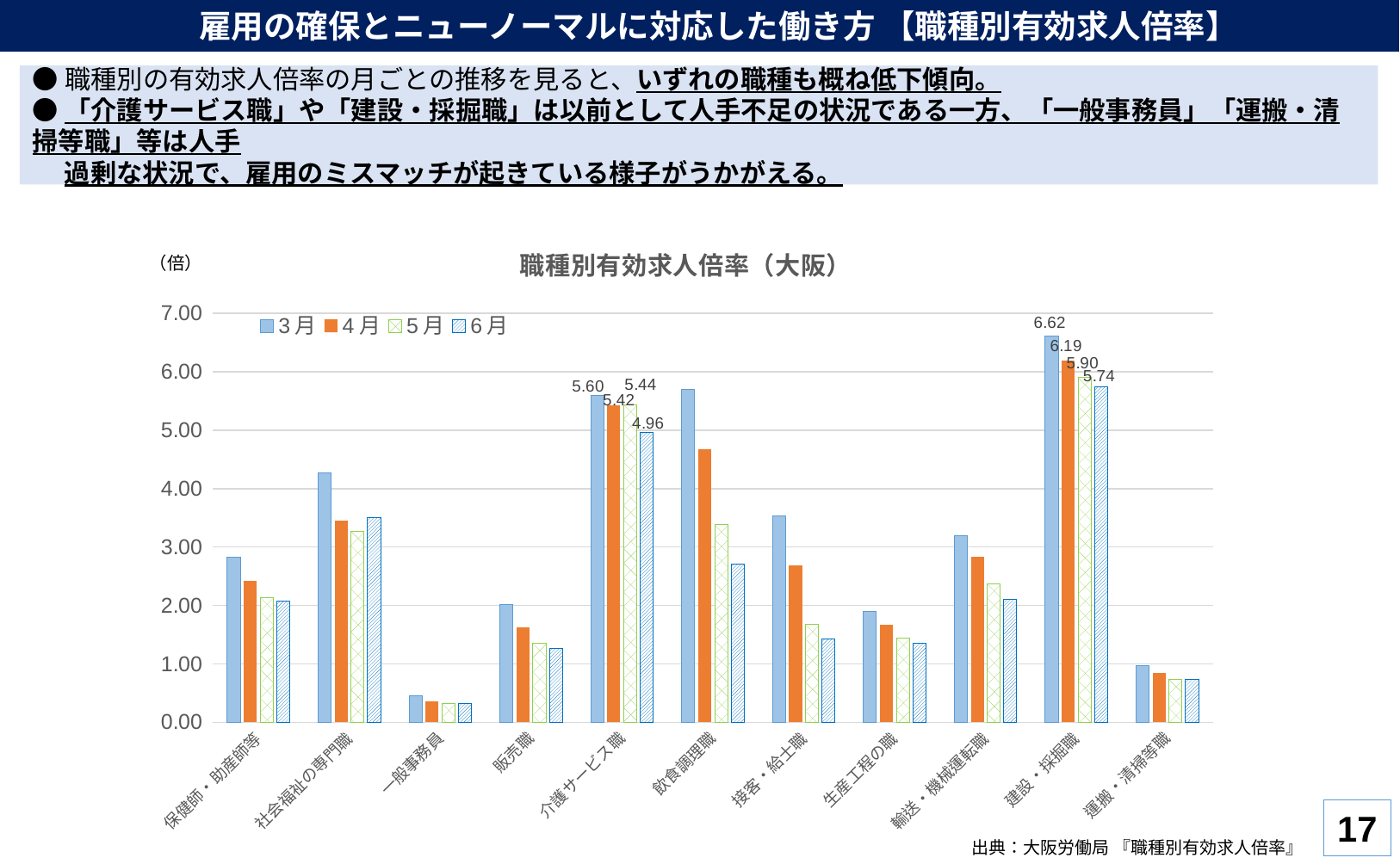
What kind of chart is shown on the slide? bar chart Is the 3月 value for 飲食調理職 greater or less than 5.00? greater Which occupation has the lowest 3月 value? 一般事務員 How many series does the legend of the chart 職種別有効求人倍率（大阪） list? 4 What is the value for 介護サービス職 in 6月? 4.96 Which is larger, the 4月 value for 建設・採掘職 or the 4月 value for 介護サービス職? 建設・採掘職 What is the difference between the 3月 and 6月 values for 建設・採掘職? 0.88 What is the value for 建設・採掘職 in 5月? 5.90 Which occupation has the highest 3月 value? 建設・採掘職 What is the difference between the 3月 and 4月 values for 介護サービス職? 0.18 What is the value for 建設・採掘職 in 3月? 6.62 How many occupation categories are shown on the x axis of the chart? 11